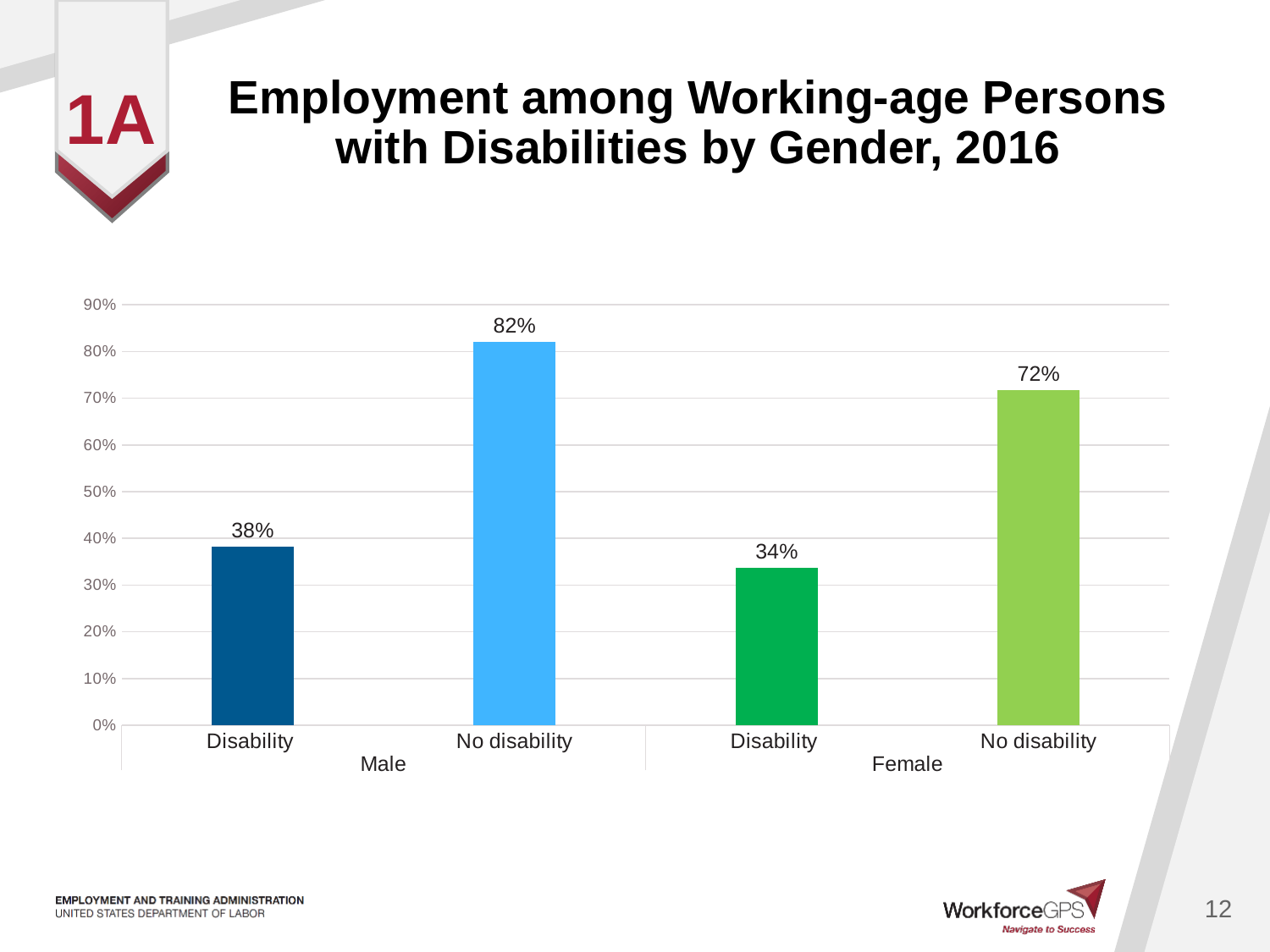
Which is larger: the employment rate for females with no disability or for males with no disability? Males with no disability What is the difference between the employment rates of males with no disability and males with a disability? 44% What is the employment rate for females with no disability? 72% What is the employment rate for males with no disability? 82% Which bar has the lowest value? Female, Disability What type of chart is shown on the slide? Bar chart What is the employment rate for males with a disability? 38% Is the employment rate for females with a disability greater or less than 40%? less How many bars are shown in the chart? 4 Which bar has the highest value? Male, No disability What is the difference between the employment rates of males with a disability and females with a disability? 4% What is the title of the chart on the slide? Employment among Working-age Persons with Disabilities by Gender, 2016